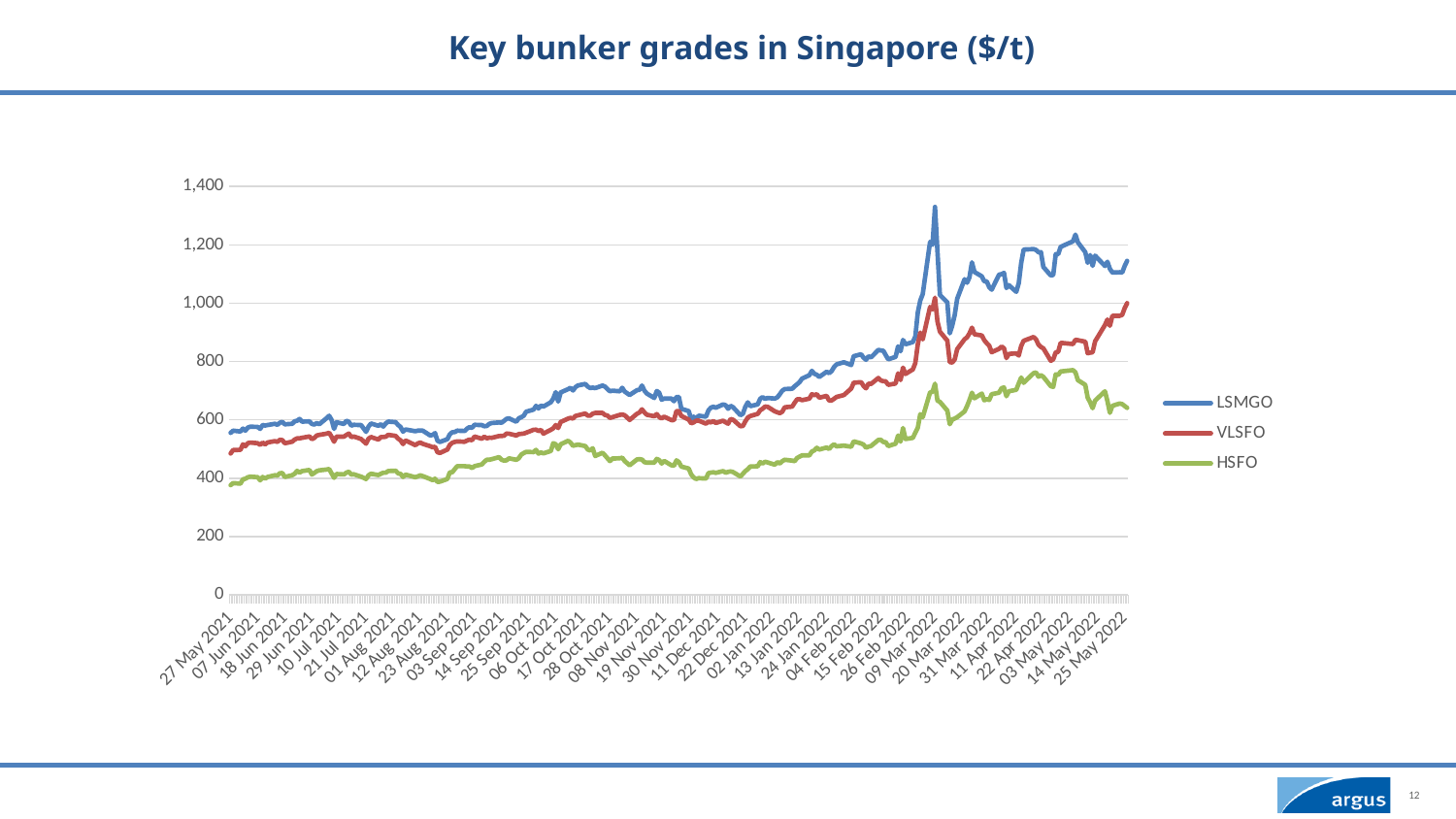
On 25 May 2022, which is larger, the value for LSMGO or the value for HSFO? LSMGO How many series does the legend list? 3 Is the value for LSMGO on 25 May 2022 greater or less than 1,000? greater Is the value for VLSFO on 27 May 2021 greater or less than 600? less Is the peak value of LSMGO in March 2022 greater or less than 1,200? greater Which series has the highest values across the chart? LSMGO What is the title of the chart? Key bunker grades in Singapore ($/t) Do the LSMGO values generally rise or fall from 27 May 2021 to 25 May 2022? rise Which series is plotted with the green line? HSFO What kind of chart is shown on the slide? line chart Which series has the lowest values across the chart? HSFO